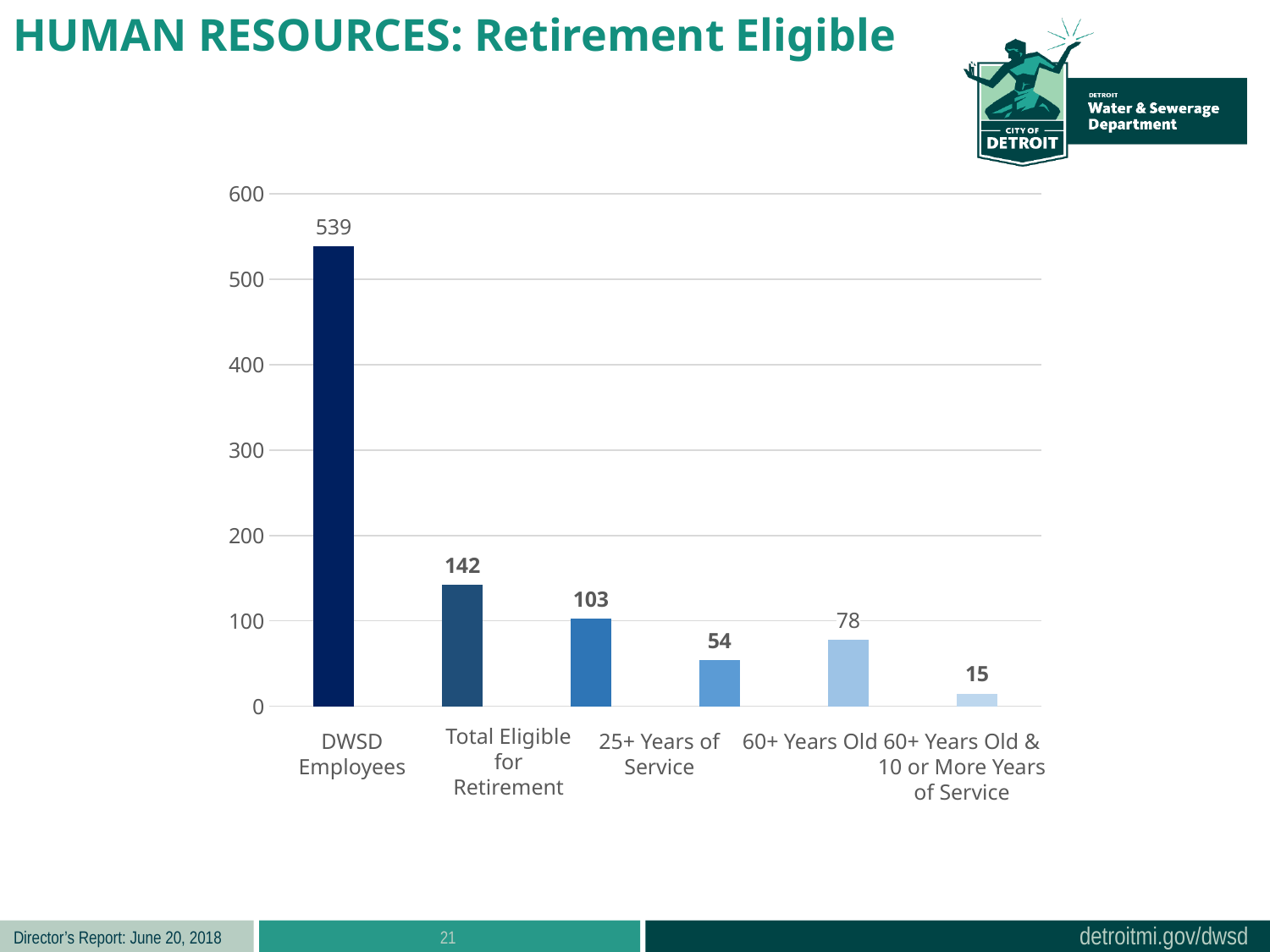
What is the value for Total Eligible for Retirement? 142 What is the value for 25+ Years of Service? 103 What is the value for 60+ Years Old & 10 or More Years of Service? 15 How many bars are plotted in the chart? 6 Which is larger, 25+ Years of Service or 60+ Years Old? 25+ Years of Service What is the difference between DWSD Employees and Total Eligible for Retirement? 397 What kind of chart is shown on the slide? Bar chart Which category has the highest value? DWSD Employees What is the value for DWSD Employees? 539 What is the difference between 25+ Years of Service and 60+ Years Old? 25 What is the value for 60+ Years Old? 78 Which category has the lowest value? 60+ Years Old & 10 or More Years of Service